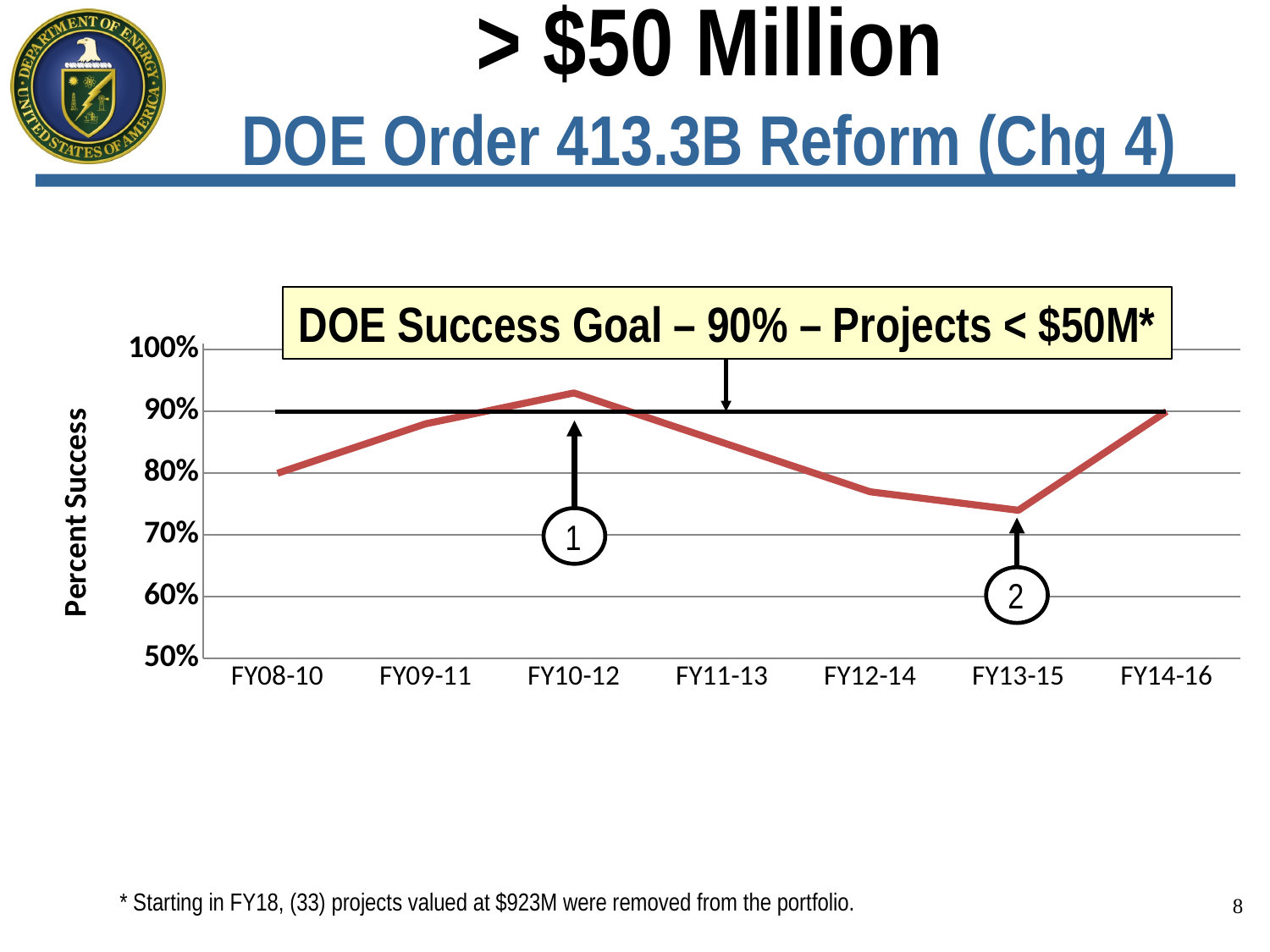
Is the percent success for FY10-12 greater or less than 90%? greater Which period has the lowest percent success? FY13-15 What kind of chart is shown on the slide? line chart How many fiscal-year periods are plotted along the x axis? 7 What DOE success goal percentage is marked by the horizontal line on the chart? 90% Which has the higher percent success, FY09-11 or FY12-14? FY09-11 What is the percent success for FY08-10? 80% Which period has the highest percent success? FY10-12 Is the percent success for FY13-15 greater or less than 80%? less Does the percent success rise or fall from FY10-12 to FY13-15? fall Is the percent success for FY12-14 greater or less than 80%? less What is the title of the y axis? Percent Success